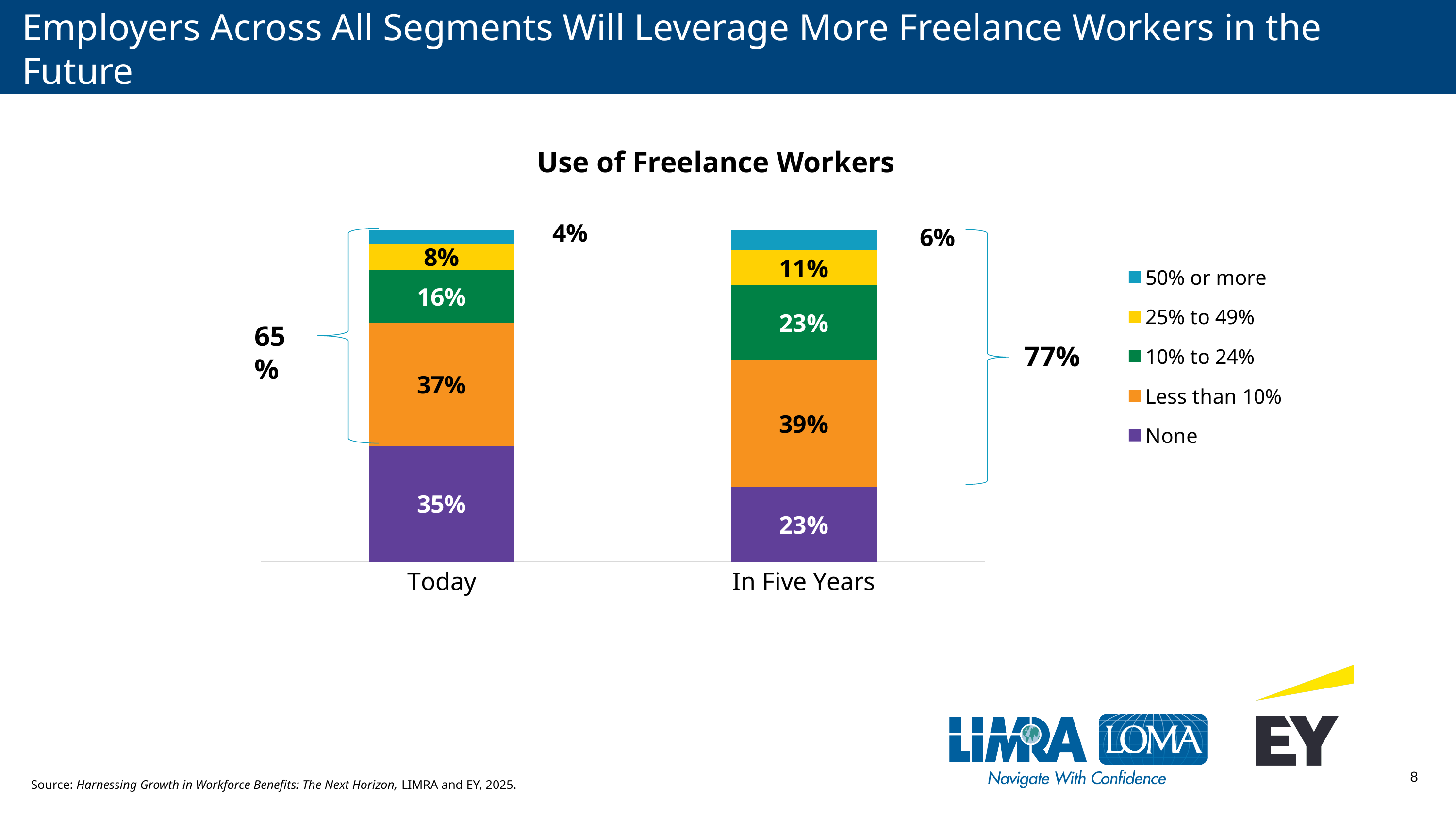
By how many percentage points does the 'None' share fall from Today to In Five Years? 12 What is the value for '50% or more' in the Today bar? 4% What is the value for '10% to 24%' in the In Five Years bar? 23% Is the '25% to 49%' share larger Today or In Five Years? In Five Years Which segment is the largest in the Today bar? Less than 10% What type of chart is shown? Stacked bar chart What share of employers expect to use 'Less than 10%' freelance workers in five years? 39% What is the title of the chart? Use of Freelance Workers How many series does the legend list? 5 Which segment is the smallest in the In Five Years bar? 50% or more How many categories are shown on the x axis? 2 What percentage of employers use no freelance workers today? 35%